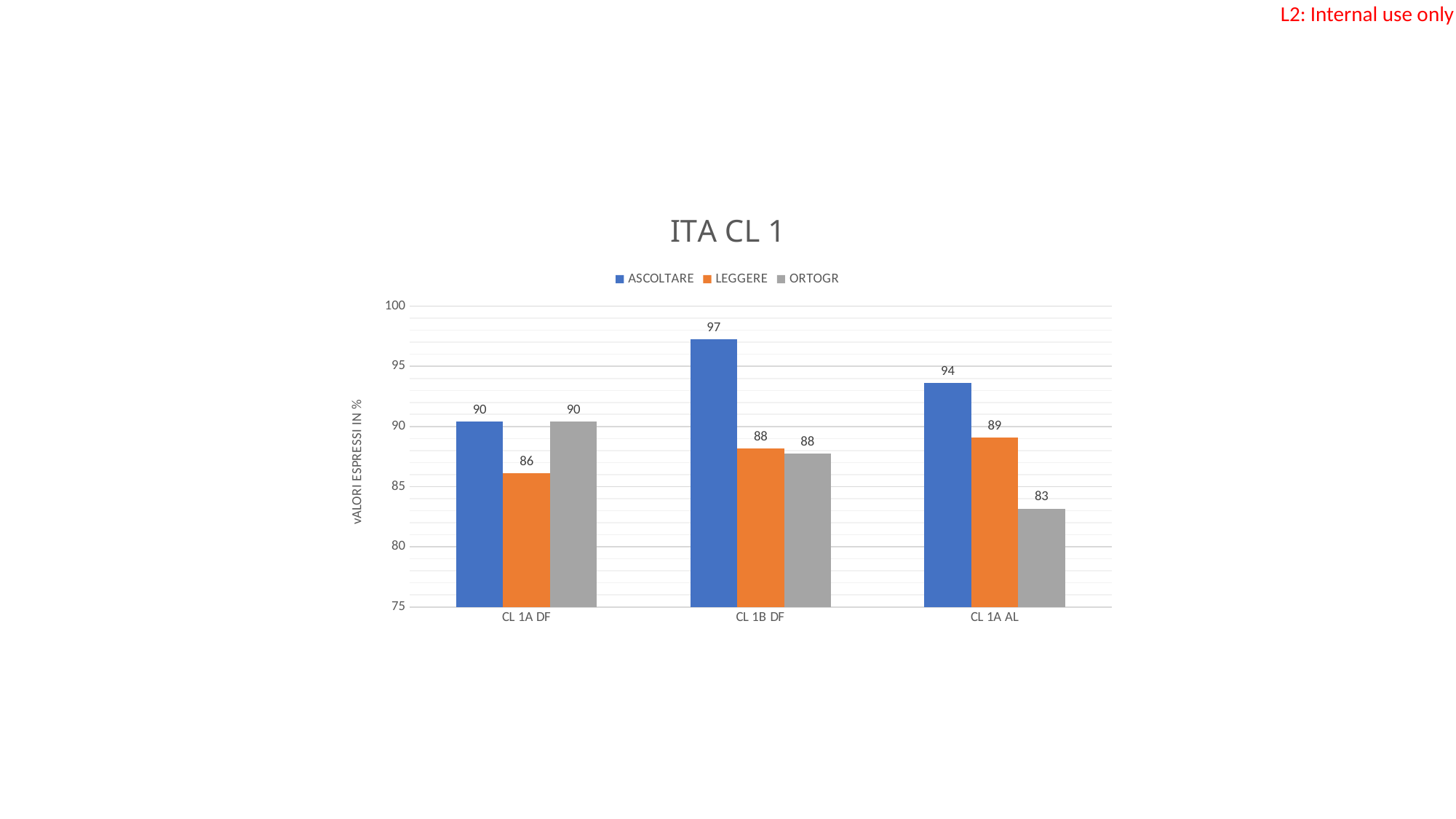
What is the title of the chart? ITA CL 1 Which category has the lowest ORTOGR value? CL 1A AL What is the LEGGERE value for CL 1A DF? 86 Which category has the highest ASCOLTARE value? CL 1B DF What is the ORTOGR value for CL 1A AL? 83 What kind of chart is shown? bar chart Is the ASCOLTARE value for CL 1A AL greater or less than 90? greater What is the ASCOLTARE value for CL 1B DF? 97 What is the difference between the ASCOLTARE and ORTOGR values for CL 1A AL? 11 Which is larger for CL 1B DF: ASCOLTARE or LEGGERE? ASCOLTARE How many categories are shown on the x axis? 3 How many series does the legend list? 3